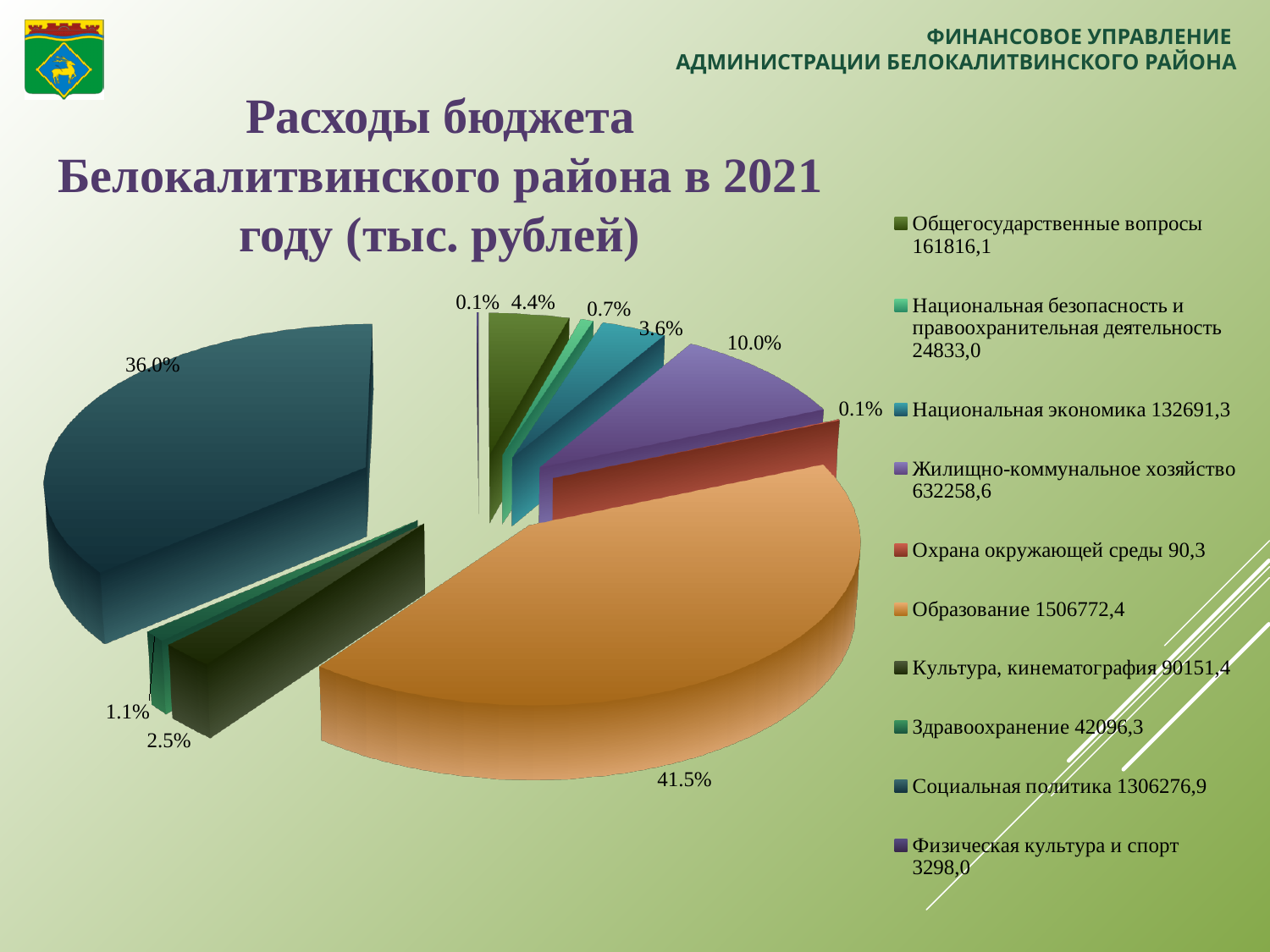
Which is larger: Общегосударственные вопросы or Национальная экономика? Общегосударственные вопросы What share of the pie does Социальная политика take? 36.0% What is the difference between the values for Общегосударственные вопросы and Национальная экономика? 29124,8 What share of the pie does Образование take? 41.5% What kind of chart is shown on the slide? Pie chart What is the value shown in the legend for Охрана окружающей среды? 90,3 Which category has the largest expenditure? Образование Which category has the smallest expenditure according to the legend values? Охрана окружающей среды What is the value shown in the legend for Социальная политика? 1306276,9 How many expenditure categories does the legend list? 10 What is the value shown in the legend for Образование? 1506772,4 What is the title of the chart? Расходы бюджета Белокалитвинского района в 2021 году (тыс. рублей)